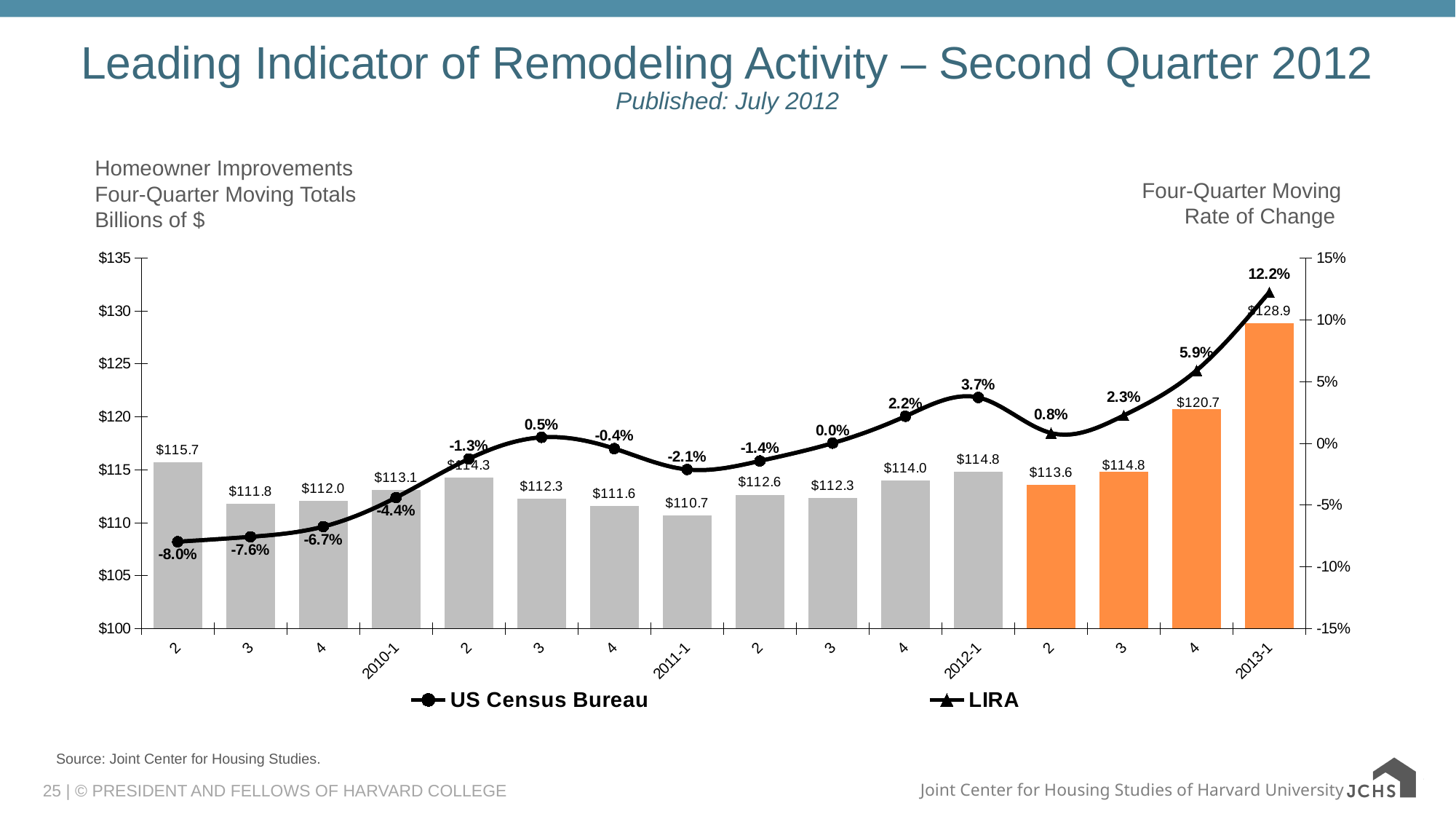
What is the difference between the bar value for 2013-1 ($128.9) and the bar immediately before it ($120.7)? $8.2 Which quarter has the highest bar value? 2013-1 What is the four-quarter moving rate of change shown for 2012-1? 3.7% How many series does the legend list? 2 What is the value of the bar for 2013-1? $128.9 Which is larger, the bar value for 2010-1 or for 2011-1? 2010-1 What is the value of the bar for 2011-1? $110.7 Does the rate of change line rise or fall from 2012-1's following quarter (0.8%) through 2013-1? rise What is the four-quarter moving rate of change shown for 2013-1? 12.2% How many bars are plotted on the chart? 16 What are the two series named in the legend? US Census Bureau and LIRA Which quarter has the lowest bar value? 2011-1